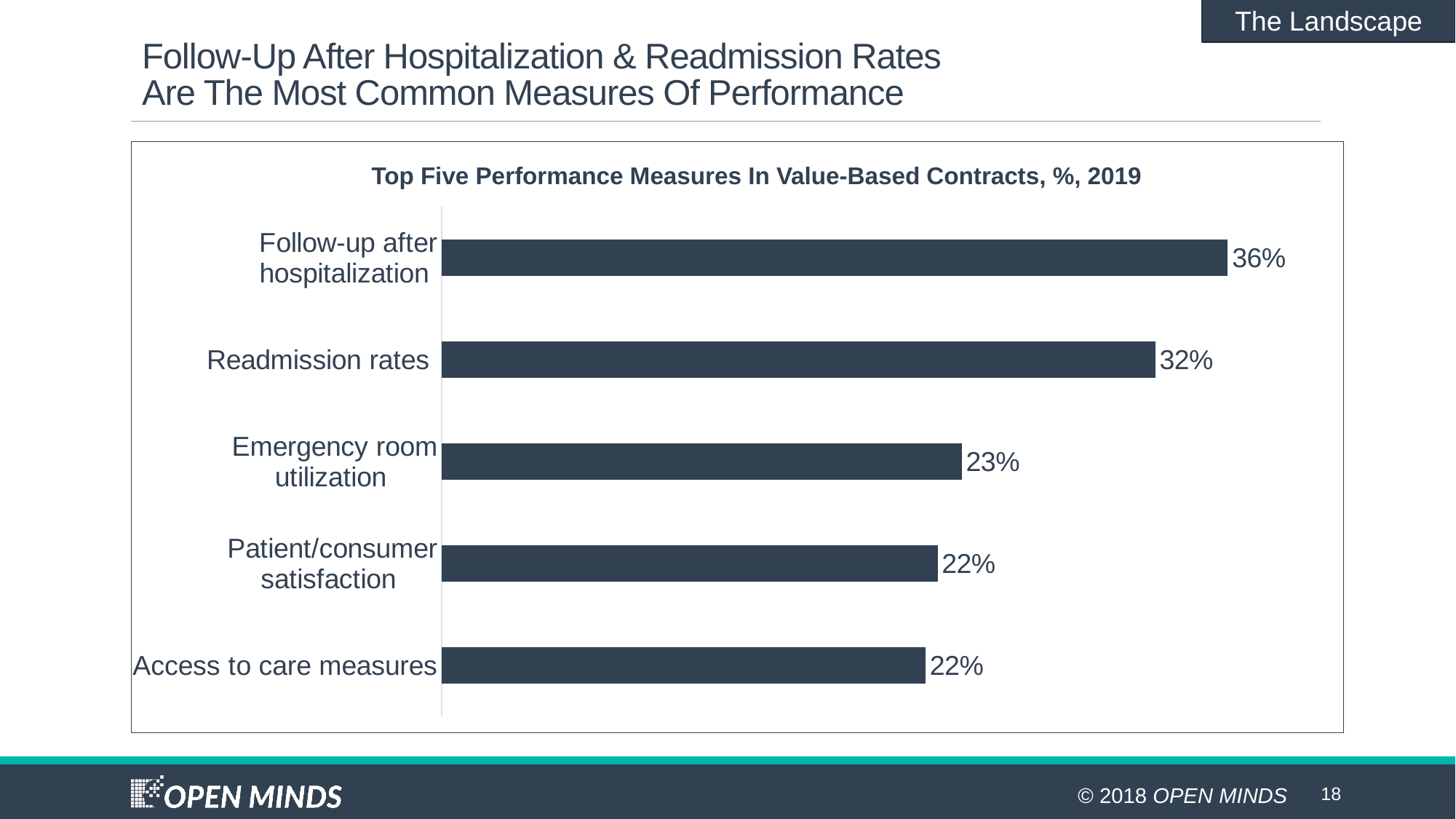
What is the difference between the values for Readmission rates and Emergency room utilization? 9% What is the title of the chart? Top Five Performance Measures In Value-Based Contracts, %, 2019 What is the value for Emergency room utilization? 23% What is the value for Follow-up after hospitalization? 36% What is the value for Patient/consumer satisfaction? 22% What is the difference between the values for Follow-up after hospitalization and Readmission rates? 4% What is the value for Readmission rates? 32% What kind of chart is shown on the slide? Bar chart How many performance measures are shown in the chart? 5 Which is larger, the value for Readmission rates or the value for Emergency room utilization? Readmission rates Which performance measure has the highest value? Follow-up after hospitalization Which two performance measures share the same value of 22%? Patient/consumer satisfaction and Access to care measures